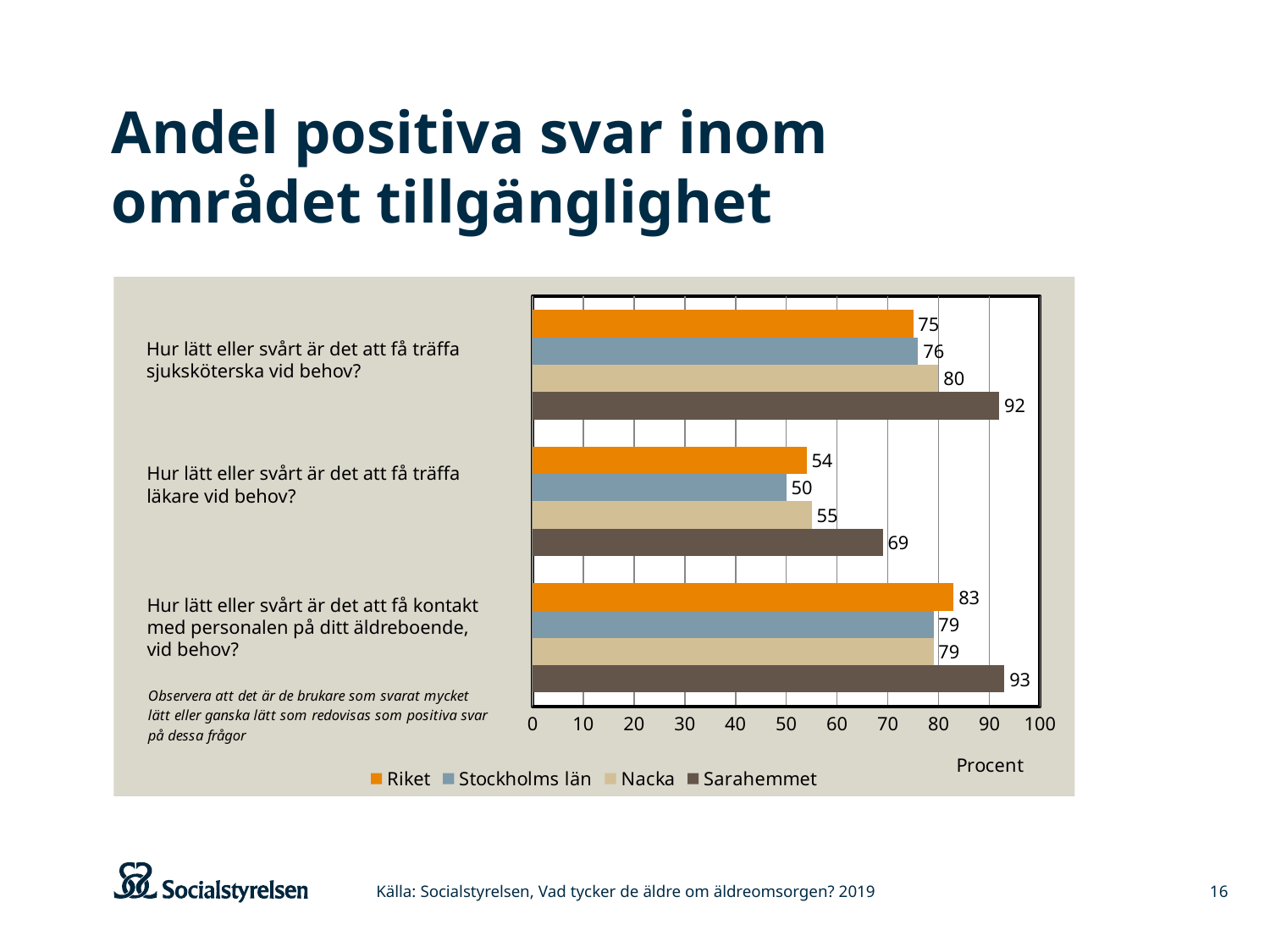
What is the value for Sarahemmet on the question "Hur lätt eller svårt är det att få träffa sjuksköterska vid behov?"? 92 What kind of chart is shown on the slide? Bar chart How many series does the legend list? 4 Which series has the highest value on the question "Hur lätt eller svårt är det att få träffa läkare vid behov?"? Sarahemmet Which series has the lowest value on the question "Hur lätt eller svårt är det att få träffa läkare vid behov?"? Stockholms län What is the difference between Sarahemmet and Riket on the question "Hur lätt eller svårt är det att få träffa sjuksköterska vid behov?"? 17 Is the value for Sarahemmet on the question "Hur lätt eller svårt är det att få träffa läkare vid behov?" greater or less than 60? greater What is the label of the horizontal axis? Procent Which is larger on the question "Hur lätt eller svårt är det att få kontakt med personalen på ditt äldreboende, vid behov?": Riket or Nacka? Riket What is the value for Stockholms län on the question "Hur lätt eller svårt är det att få kontakt med personalen på ditt äldreboende, vid behov?"? 79 What is the value for Riket on the question "Hur lätt eller svårt är det att få träffa läkare vid behov?"? 54 How many questions (categories) are shown on the chart? 3